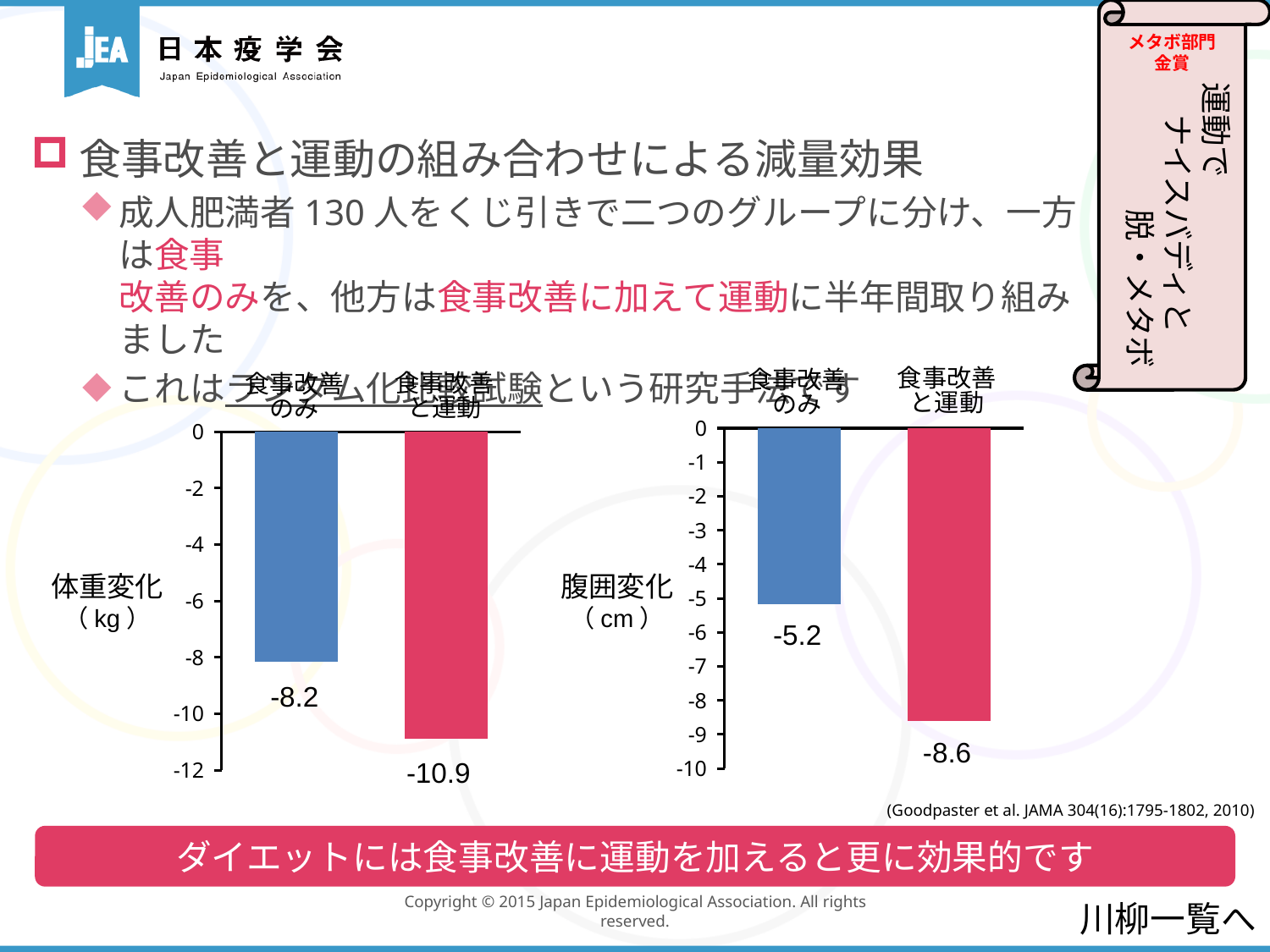
In the right chart (腹囲変化（cm）), what is the value for 食事改善のみ? -5.2 In the left chart (体重変化（kg）), which category has the lowest value? 食事改善と運動 In the right chart (腹囲変化（cm）), which category has the lowest value? 食事改善と運動 In the left chart (体重変化（kg）), what is the value for 食事改善のみ? -8.2 In the left chart (体重変化（kg）), what colour is the bar for 食事改善と運動? red What kind of chart is the right chart (腹囲変化（cm）)? bar chart In the left chart (体重変化（kg）), what is the value for 食事改善と運動? -10.9 In the right chart (腹囲変化（cm）), is the value for 食事改善のみ greater or less than -6? greater In the right chart (腹囲変化（cm）), what is the value for 食事改善と運動? -8.6 In the right chart (腹囲変化（cm）), what is the difference between the values for 食事改善のみ and 食事改善と運動? 3.4 How many categories does the left chart (体重変化（kg）) show? 2 In the left chart (体重変化（kg）), what is the difference between the values for 食事改善のみ and 食事改善と運動? 2.7